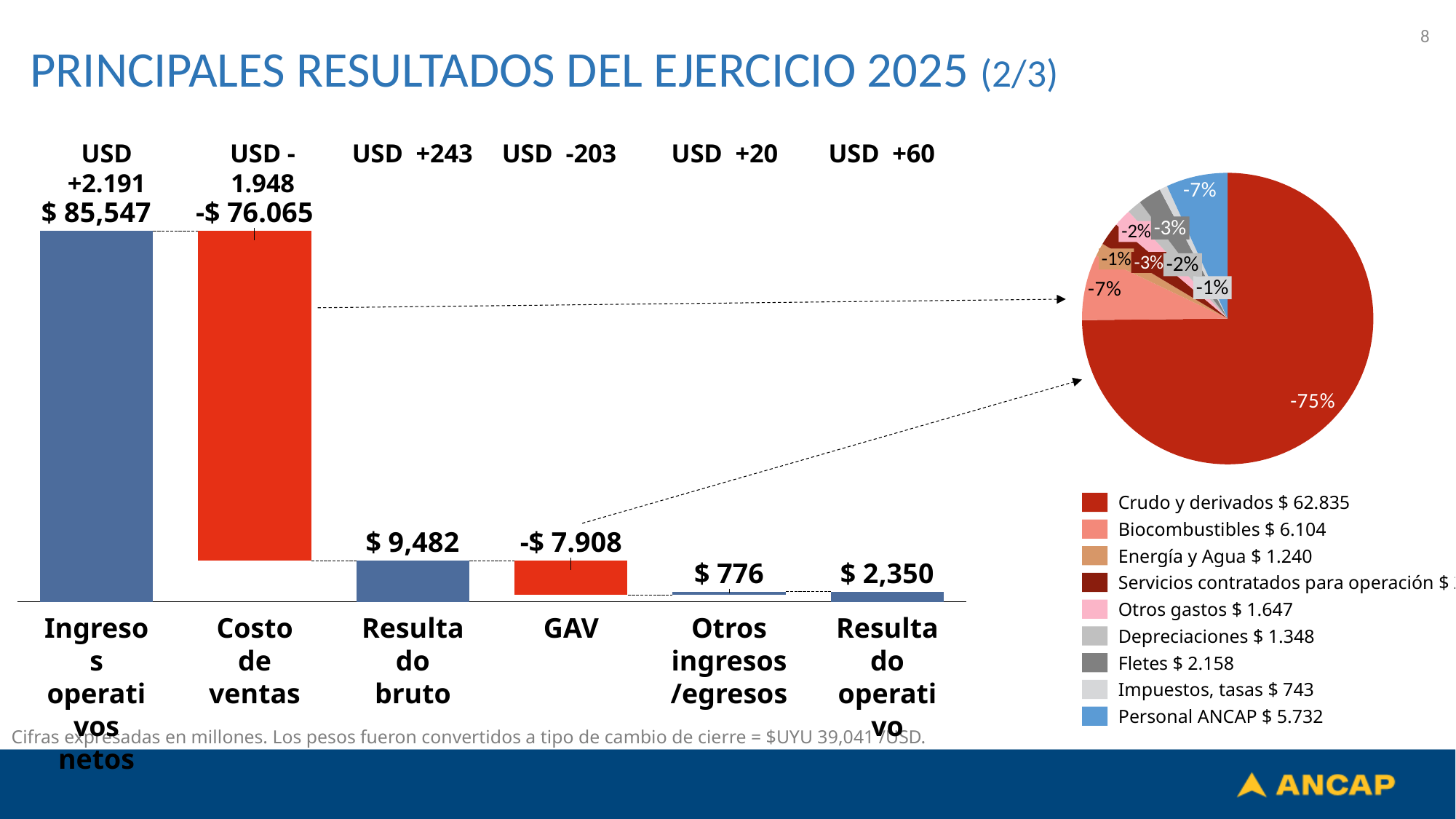
On the bar chart on the left, how many categories are shown on the x axis? 6 On the bar chart on the left, what is the value shown for Ingresos operativos netos? $ 85,547 On the bar chart on the left, which of Otros ingresos/egresos and Resultado operativo has the larger value? Resultado operativo On the bar chart on the left, what is the value shown for GAV? -$ 7.908 On the bar chart on the left, what USD figure is shown above the Resultado bruto bar? USD +243 How many entries does the legend of the pie chart on the right list? 9 On the pie chart on the right, what share is shown for Crudo y derivados? -75% On the pie chart on the right, what value does the legend give for Personal ANCAP? $ 5.732 On the bar chart on the left, what is the value shown for Costo de ventas? -$ 76.065 On the bar chart on the left, what is the value shown for Resultado operativo? $ 2,350 What kind of chart is shown on the right side of the slide? Pie chart On the bar chart on the left, what is the value shown for Resultado bruto? $ 9,482